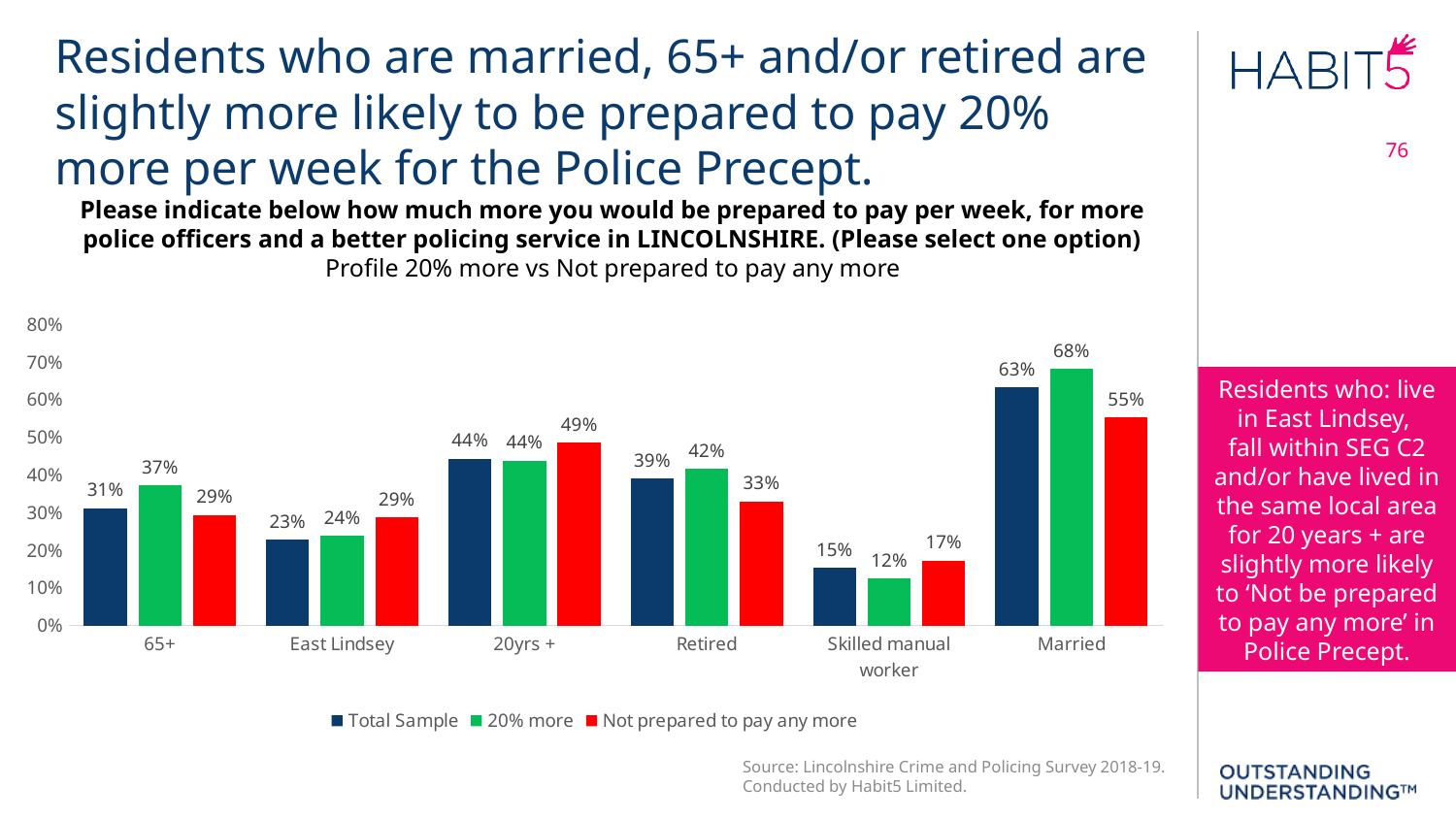
Which category has the lowest Total Sample value? Skilled manual worker How many series does the legend list? 3 What is the Total Sample value for the Skilled manual worker category? 15% What is the value for '20% more' in the Married category? 68% What kind of chart is shown on the slide? Bar chart For the 65+ category, which is larger: the '20% more' value or the 'Not prepared to pay any more' value? 20% more Is the Total Sample value for Married greater or less than 60%? greater What is the 'Not prepared to pay any more' value for the 20yrs + category? 49% What is the difference between the '20% more' and 'Not prepared to pay any more' values for the Retired category? 9% Which series is shown in red in the legend? Not prepared to pay any more Which category has the highest '20% more' value? Married How many categories are shown on the x axis? 6